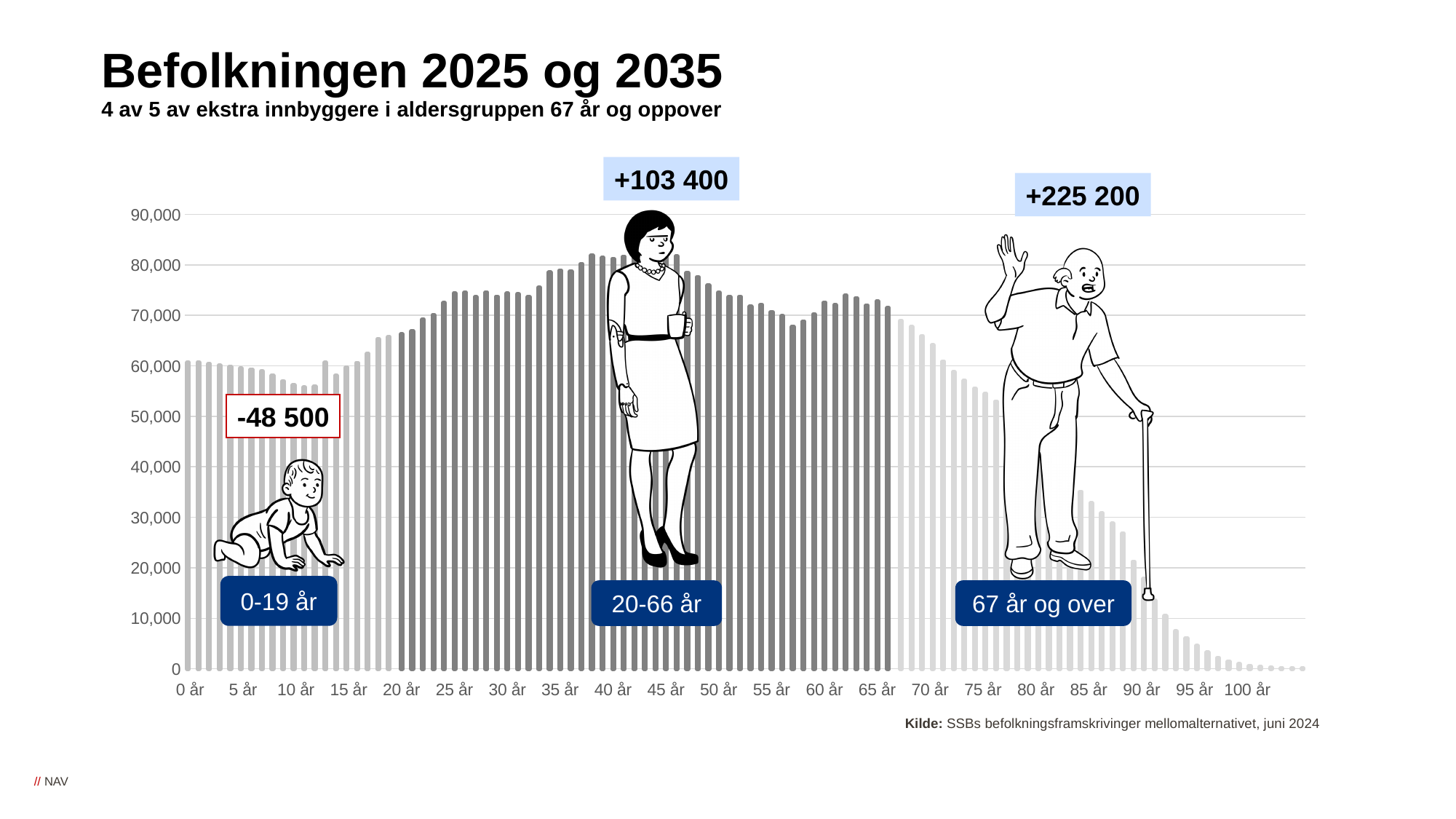
Is the value for 100 år greater or less than 10,000? less What change is shown for the age group 20-66 år? +103 400 What is the title of the chart on the slide? Befolkningen 2025 og 2035 Which is larger, the value for 20 år or the value for 80 år? 20 år Which age group shows a decrease? 0-19 år What is the difference between the change for 67 år og over and the change for 20-66 år? 121 800 What change is shown for the age group 67 år og over? +225 200 What kind of chart is shown on the slide? bar chart What change is shown for the age group 0-19 år? -48 500 Which age group has the largest increase shown on the chart? 67 år og over Do the values rise or fall along the x axis from 70 år to 100 år? fall Is the value for 30 år greater or less than 70,000? greater